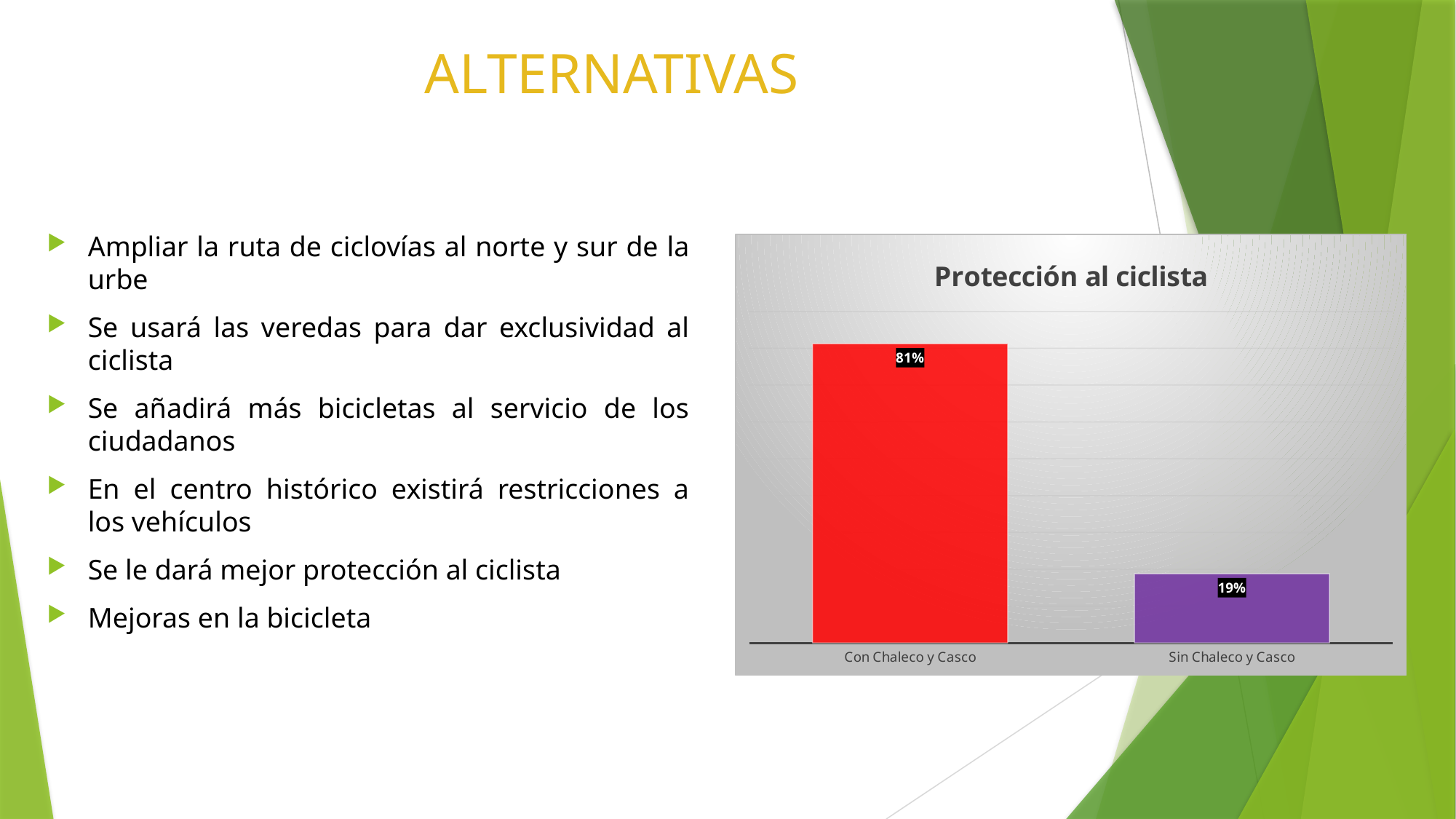
What is the title of the chart? Protección al ciclista What colour is the bar for Sin Chaleco y Casco? Purple What is the value for Sin Chaleco y Casco? 19% Which category has the highest value? Con Chaleco y Casco What is the total of the two values shown in the chart? 100% What kind of chart is shown on the slide? Bar chart How many categories are shown in the chart? 2 What is the value for Con Chaleco y Casco? 81% Which category has the lowest value? Sin Chaleco y Casco Which is larger, the value for Con Chaleco y Casco or Sin Chaleco y Casco? Con Chaleco y Casco What is the difference between the values for Con Chaleco y Casco and Sin Chaleco y Casco? 62%